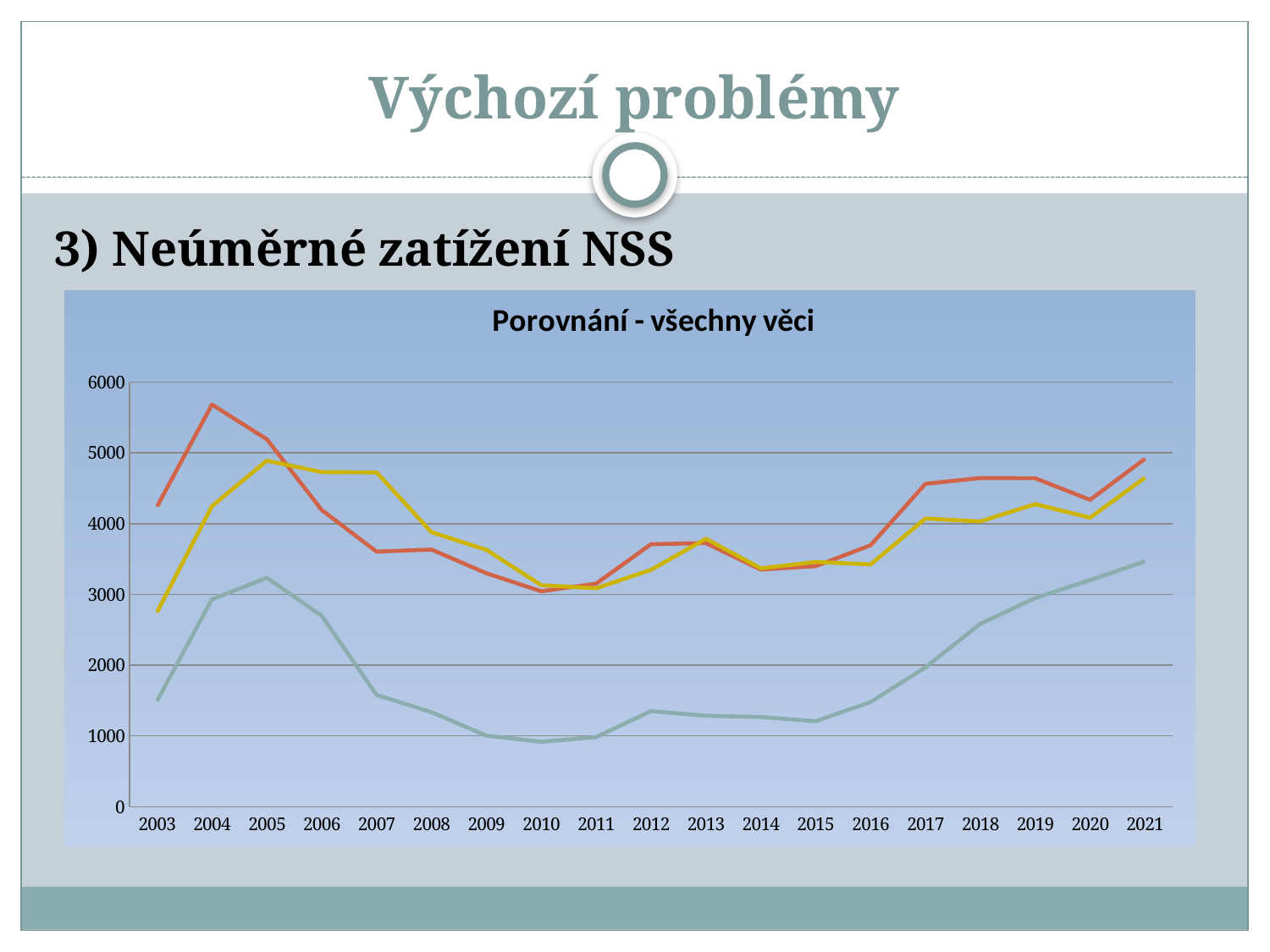
How many lines are plotted in the chart? 3 Is the value of the yellow line in 2003 greater or less than 3000? less Is the value of the light green line in 2010 greater or less than 1000? less Is the value of the red line in 2004 greater or less than 5000? greater Does the light green line rise or fall between 2015 and 2021? rise In 2021, which line has the higher value, the red line or the light green line? the red line What is the title of the chart? Porovnání - všechny věci In which year does the yellow line reach its highest value? 2005 In which year does the red line reach its highest value? 2004 What kind of chart is shown on the slide? line chart How many years are shown along the x axis of the chart? 19 In 2007, which line has the higher value, the red line or the yellow line? the yellow line